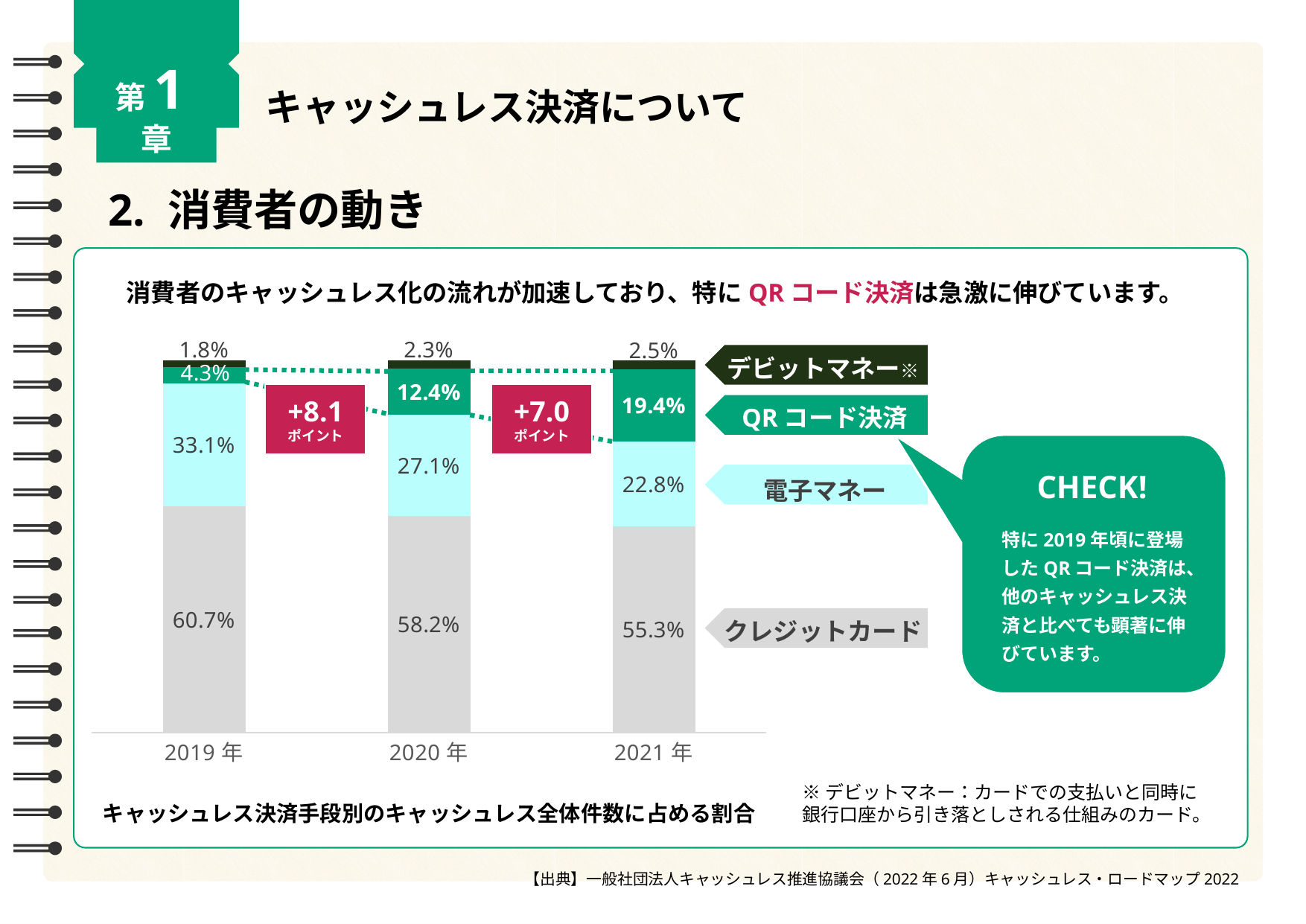
Which is larger in 2021, the share of 電子マネー or the share of QRコード決済? 電子マネー How many payment-method categories are stacked in each bar? 4 What is the share of 電子マネー in 2020? 27.1% What type of chart is shown on the slide? Stacked bar chart What is the share of QRコード決済 in 2021? 19.4% How many years are shown on the x axis? 3 What is the share of デビットマネー in 2021? 2.5% By how many percentage points did the share of QRコード決済 change from 2019 to 2020? +8.1 ポイント What is the difference between the クレジットカード share in 2019 and in 2021? 5.4 percentage points What is the share of クレジットカード in 2019? 60.7% In which year is the share of QRコード決済 the highest? 2021年 In which year is the share of クレジットカード the lowest? 2021年